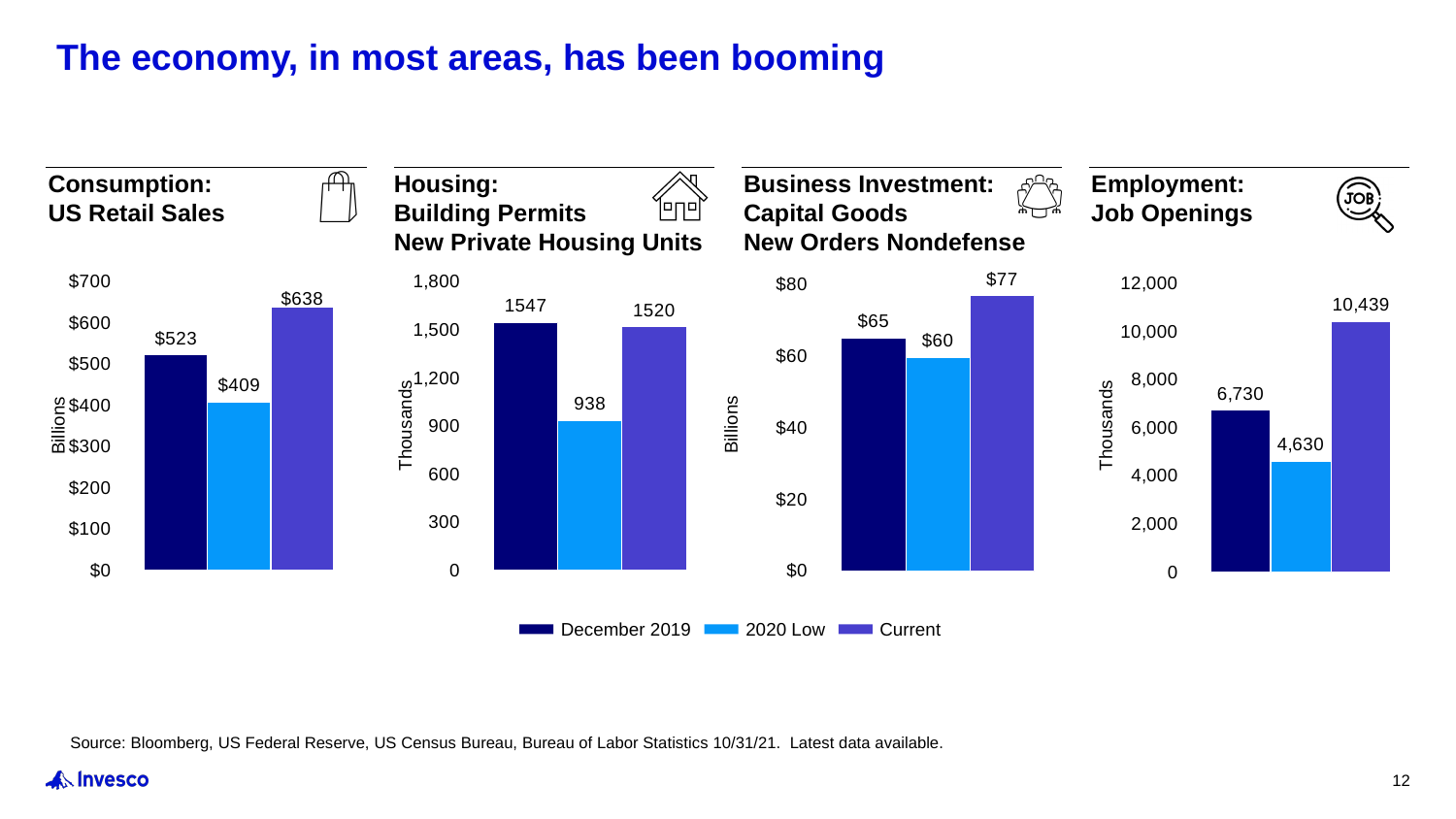
In the Housing: Building Permits chart, what is the value for December 2019? 1547 In the Consumption: US Retail Sales chart, what is the value for the 2020 Low? $409 In the Housing: Building Permits chart, is December 2019 or Current larger? December 2019 In the Employment: Job Openings chart, what is the difference between Current and December 2019? 3,709 How many series does the legend list? 3 In the Business Investment: Capital Goods chart, what is the difference between Current and December 2019? $12 In the Housing: Building Permits chart, which series has the lowest value? 2020 Low In the Employment: Job Openings chart, which series has the highest value? Current In the Consumption: US Retail Sales chart, what is the value for Current? $638 What kind of chart is the Consumption: US Retail Sales chart? Bar chart In the Business Investment: Capital Goods chart, what is the value for Current? $77 In the Employment: Job Openings chart, what is the value for the 2020 Low? 4,630